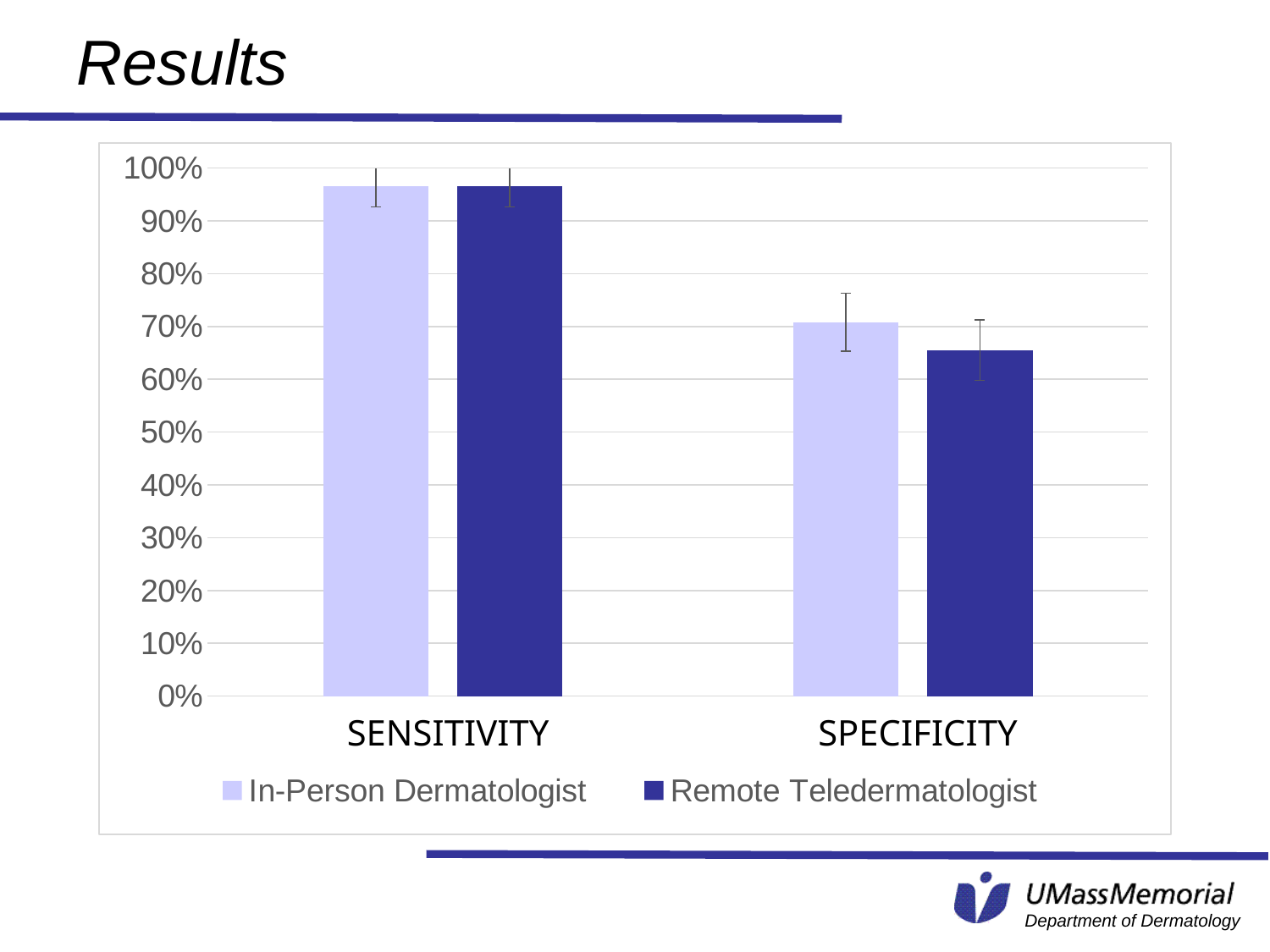
Is the Specificity value for Remote Teledermatologist greater or less than 60%? greater Is the Specificity value for Remote Teledermatologist greater or less than 70%? less Which series is shown in the darker blue colour? Remote Teledermatologist How many categories are shown on the x axis? 2 For Specificity, which series has the larger value, In-Person Dermatologist or Remote Teledermatologist? In-Person Dermatologist How many series does the legend list? 2 Is the Specificity value for In-Person Dermatologist greater or less than 60%? greater Which category has the higher values overall, Sensitivity or Specificity? Sensitivity What kind of chart is shown on the slide? bar chart For In-Person Dermatologist, which is larger, the Sensitivity value or the Specificity value? Sensitivity